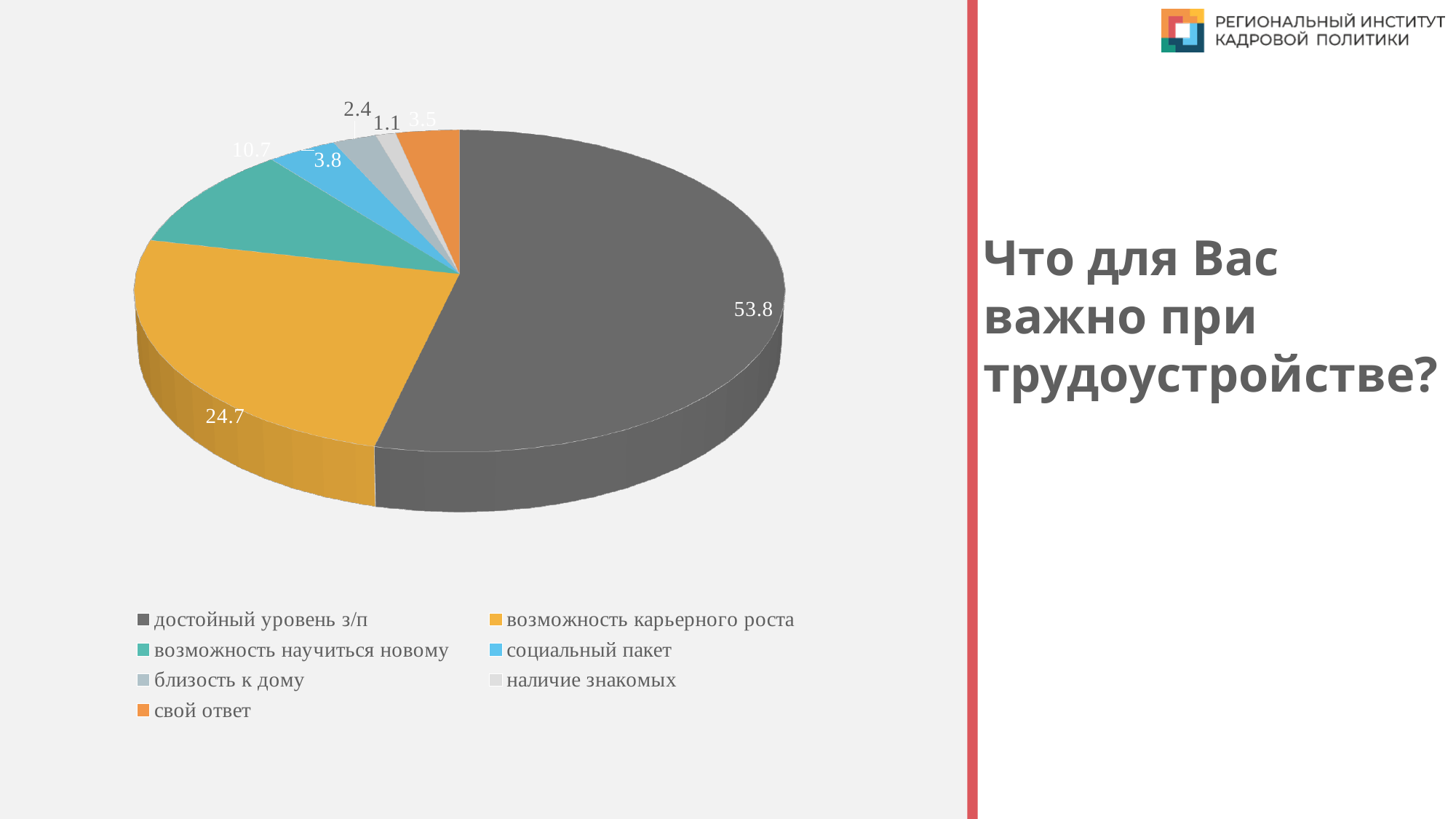
Which is larger: the value for "социальный пакет" or the value for "свой ответ"? социальный пакет Which category has the smallest slice of the pie? наличие знакомых What is the difference between the values for "достойный уровень з/п" and "возможность карьерного роста"? 29.1 What is the value for "социальный пакет"? 3.8 What is the value for "наличие знакомых"? 1.1 What kind of chart is shown on the slide? Pie chart What colour is the slice for "возможность научиться новому"? Teal What is the value for "возможность карьерного роста"? 24.7 Which category has the largest slice of the pie? достойный уровень з/п What is the value for "возможность научиться новому"? 10.7 What is the value for "достойный уровень з/п"? 53.8 How many categories does the legend list? 7